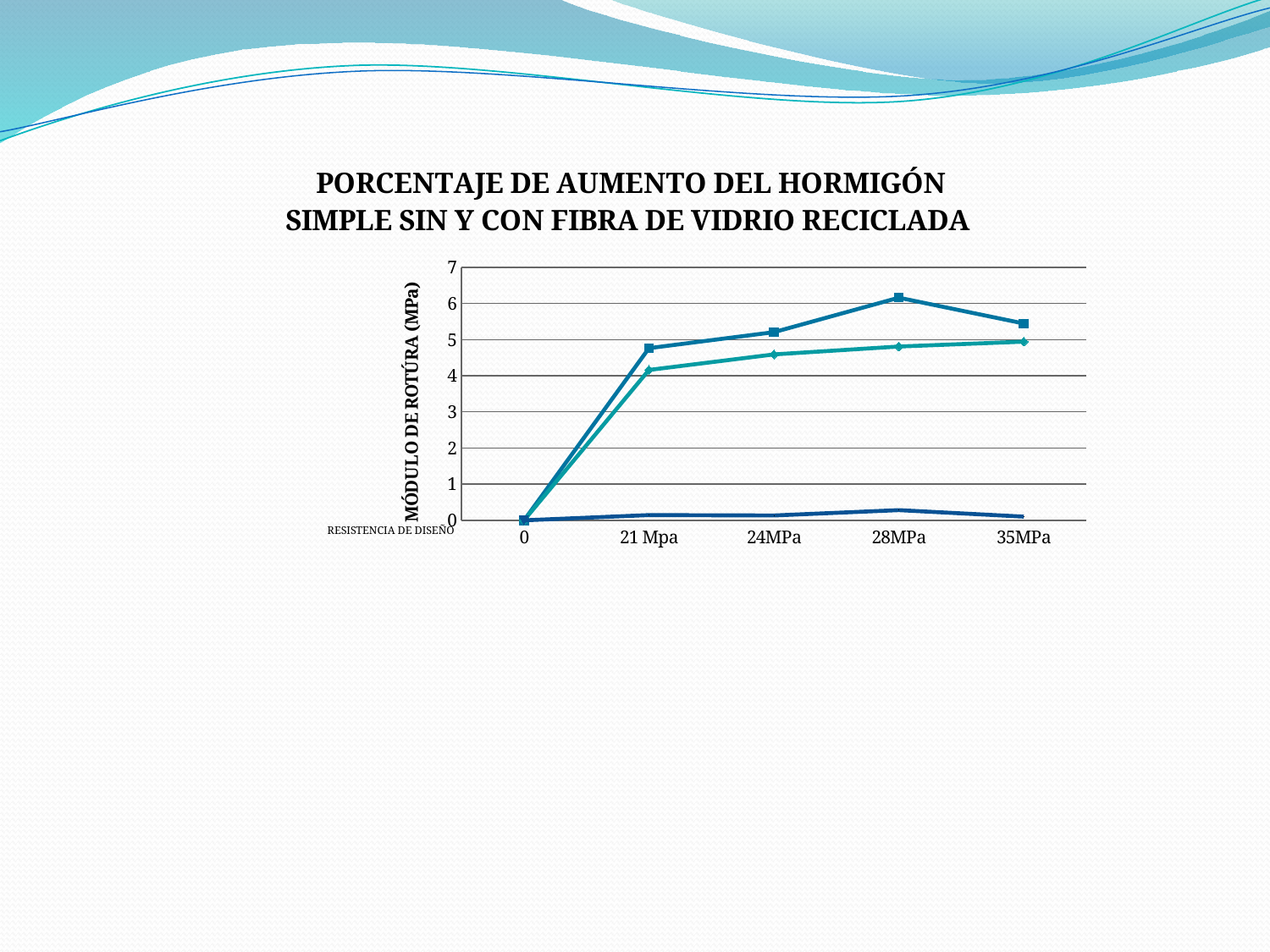
Is the value of the line with square markers at 24MPa greater or less than 5? greater How many categories are shown along the x axis? 5 What is the title of the chart? PORCENTAJE DE AUMENTO DEL HORMIGÓN SIMPLE SIN Y CON FIBRA DE VIDRIO RECICLADA Is the value of the lowest line (without markers) at 28MPa greater or less than 1? less At which x-axis category does the line with square markers reach its highest value? 28MPa What is the label of the vertical axis? MÓDULO DE ROTÚRA (MPa) Is the value of the line with diamond markers at 21 Mpa greater or less than 4? greater What kind of chart is shown on the slide? line chart Does the line with diamond markers rise or fall between 21 Mpa and 35MPa? rise At 28MPa, which line has the larger value: the line with square markers or the line with diamond markers? the line with square markers